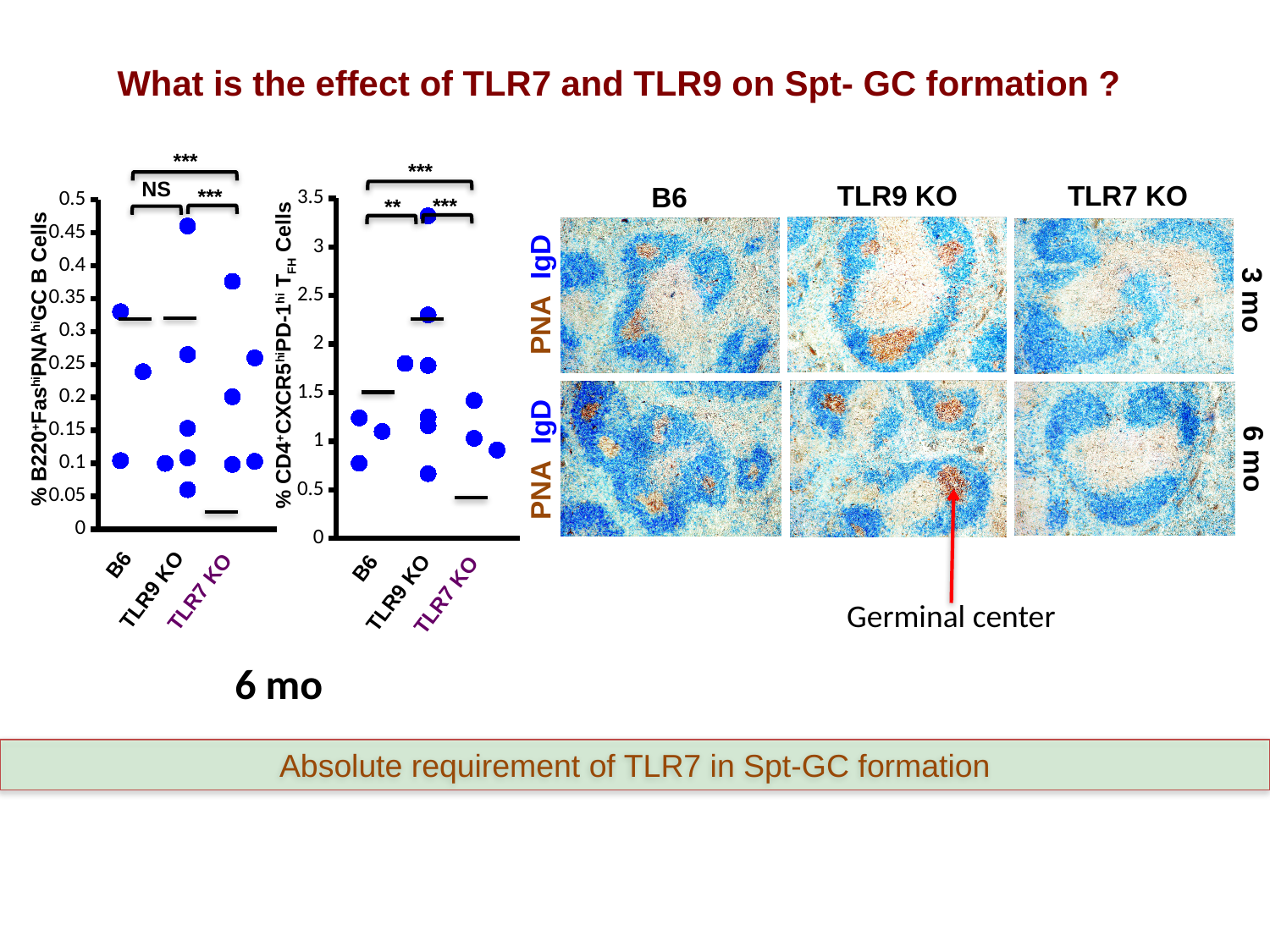
In the left chart (% B220+Fas hi PNA hi GC B Cells), is the TLR7 KO median line greater or less than 0.05? less In the right chart (% CD4+CXCR5 hi PD-1 hi TFH Cells), which group has the lowest median line? TLR7 KO In the right chart (% CD4+CXCR5 hi PD-1 hi TFH Cells), is the median line for TLR9 KO larger or smaller than the median line for TLR7 KO? larger How many groups are shown on the x axis of the right chart (% CD4+CXCR5 hi PD-1 hi TFH Cells)? 3 In the right chart (% CD4+CXCR5 hi PD-1 hi TFH Cells), which group has the highest median line? TLR9 KO In the left chart (% B220+Fas hi PNA hi GC B Cells), which group has the lowest median line? TLR7 KO What kind of chart is the left chart (% B220+Fas hi PNA hi GC B Cells)? Dot plot (scatter plot) In the right chart (% CD4+CXCR5 hi PD-1 hi TFH Cells), is the highest TLR9 KO point greater or less than 3? greater In the left chart (% B220+Fas hi PNA hi GC B Cells), what significance label is shown between B6 and TLR9 KO? NS How many groups are shown on the x axis of the left chart (% B220+Fas hi PNA hi GC B Cells)? 3 In the left chart (% B220+Fas hi PNA hi GC B Cells), is the highest TLR9 KO point greater or less than 0.4? greater